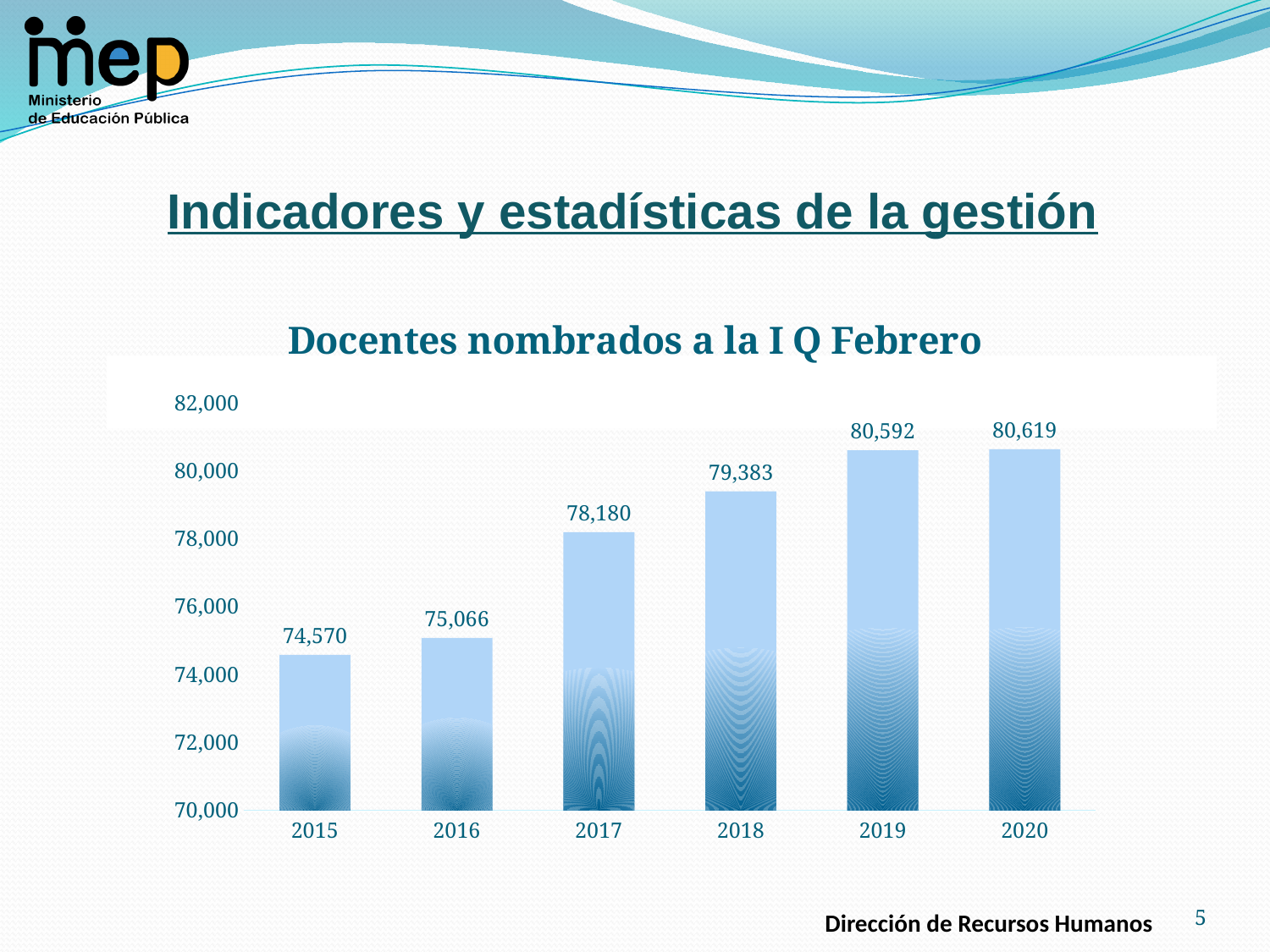
How many years are shown on the x axis? 6 What is the value for 2020? 80,619 What is the value for 2015? 74,570 Is the value for 2019 greater or less than 80,000? greater What is the title of the chart? Docentes nombrados a la I Q Febrero Which year has the lowest value? 2015 What is the value for 2018? 79,383 What is the difference between the values for 2020 and 2015? 6,049 Do the values rise or fall from 2015 to 2020? rise What is the difference between the values for 2017 and 2016? 3,114 Which is larger, the value for 2017 or the value for 2018? 2018 What kind of chart is this? bar chart